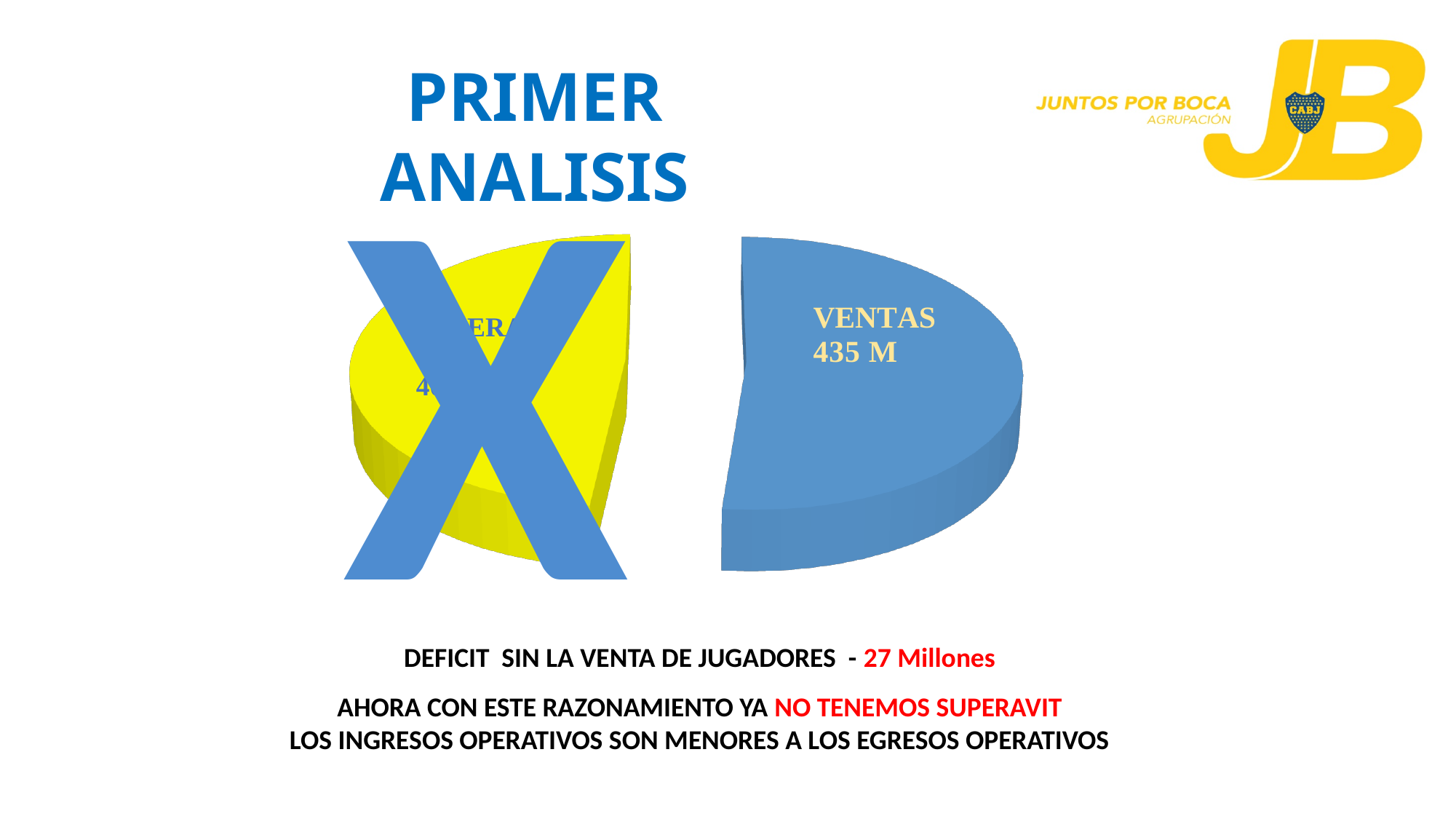
What colour is the slice of the pie chart that is covered by the large X? yellow What value is printed on the VENTAS slice of the pie chart? 435 M What colour is the VENTAS slice of the pie chart? blue How many slices does the pie chart have? 2 What kind of chart is shown on the slide? pie chart